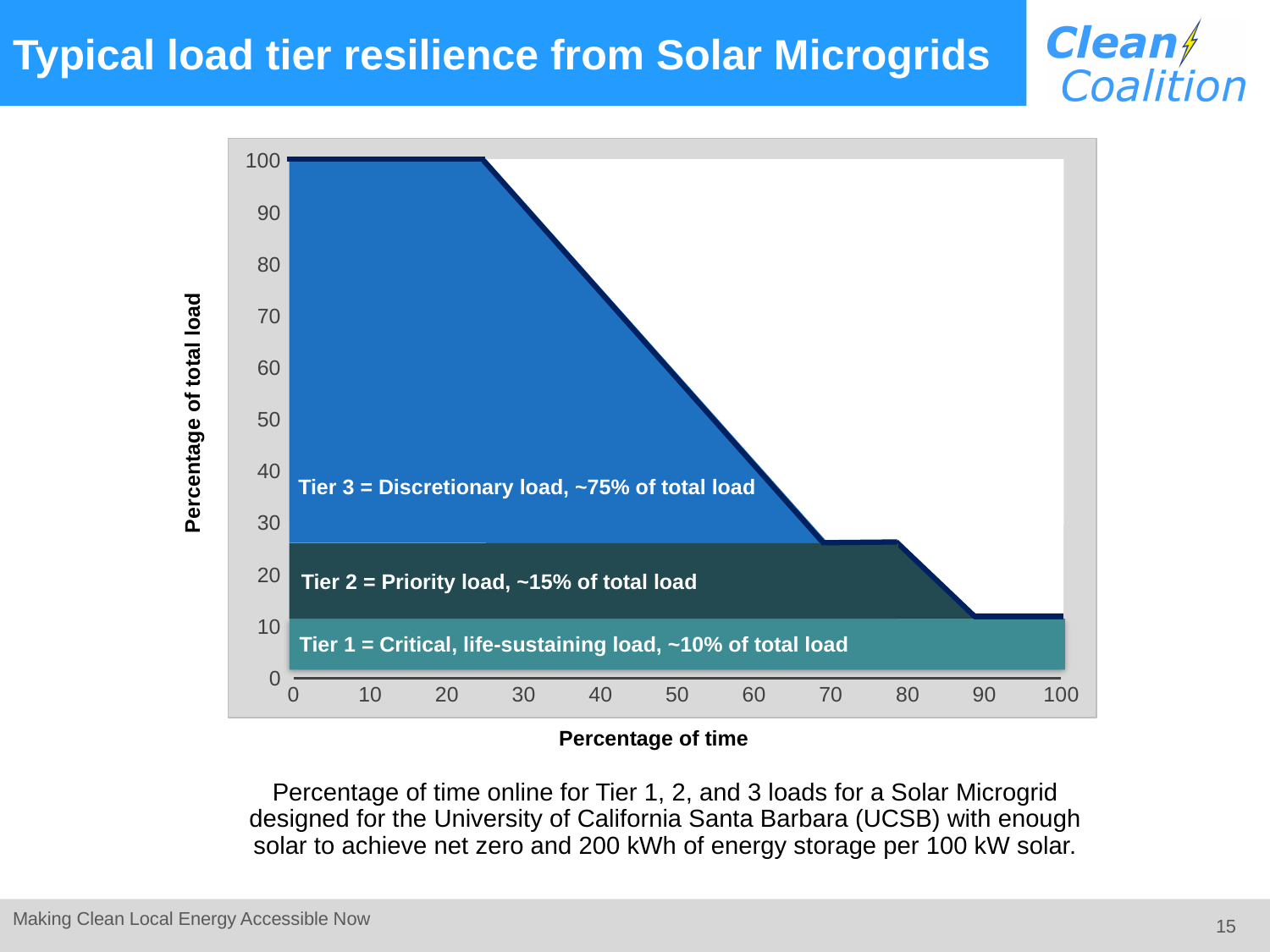
Is the percentage of total load at 10% of time greater or less than 90? greater What is the title of the chart's vertical axis? Percentage of total load Is the percentage of total load at 50% of time greater or less than 50? greater What is the highest value shown on the vertical axis of the chart? 100 What is the title of the chart's horizontal axis? Percentage of time Is the percentage of total load at 75% of time greater or less than 40? less Does the plotted percentage of total load rise or fall as the percentage of time increases along the x axis? Fall What kind of chart is shown on the slide? Area chart How many load tiers are labelled in the chart? 3